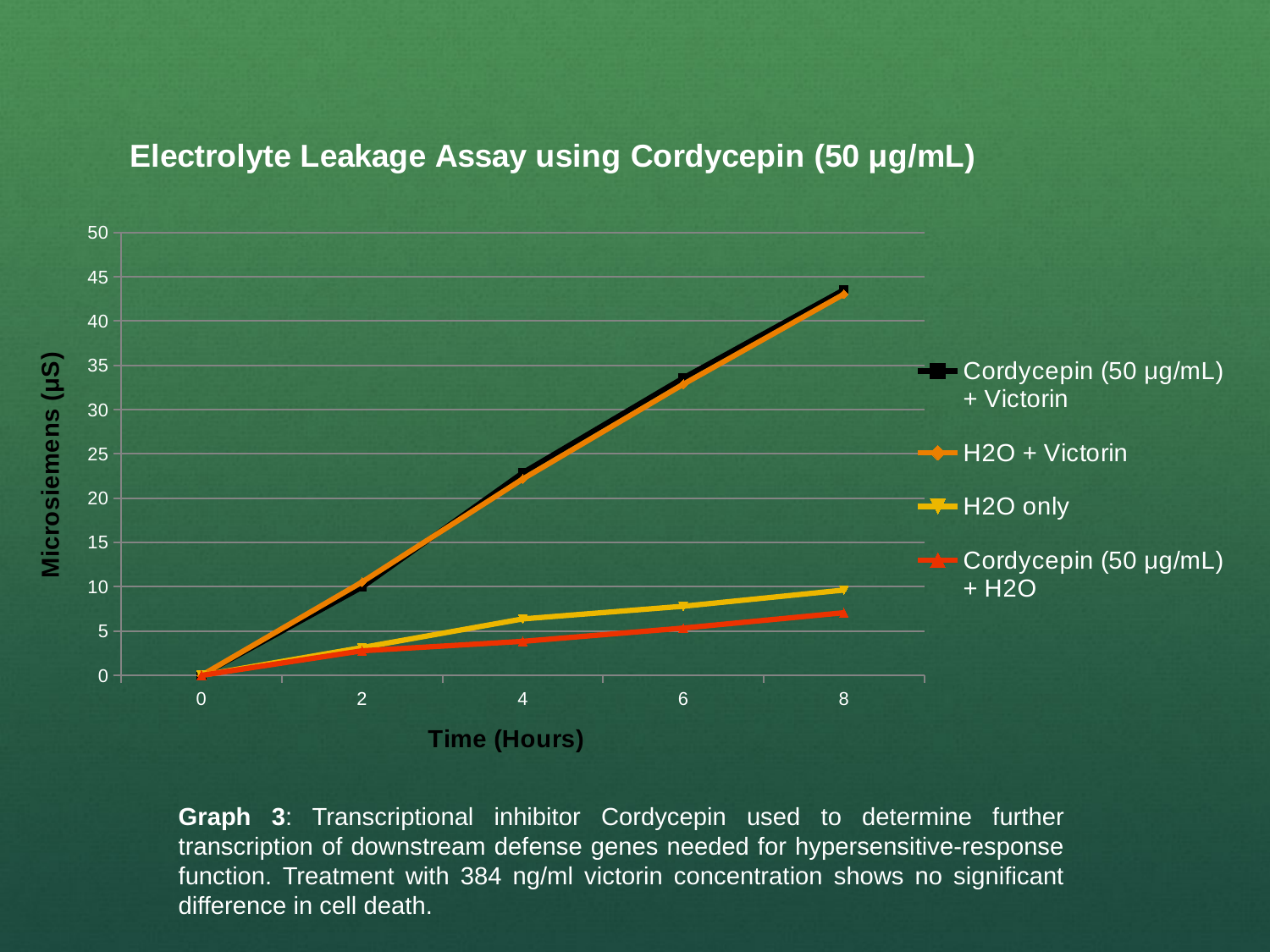
How many time points are plotted along the x axis? 5 Is the value for H2O only at 8 hours greater or less than 15? less What is the label of the y axis? Microsiemens (µS) Which series has the lowest value at 8 hours? Cordycepin (50 µg/mL) + H2O What kind of chart is shown on the slide? line chart Do the values for H2O + Victorin rise or fall as time increases? rise What is the value for Cordycepin (50 µg/mL) + Victorin at 0 hours? 0 Is the value for Cordycepin (50 µg/mL) + Victorin at 8 hours greater or less than 40? greater Is the value for Cordycepin (50 µg/mL) + H2O at 8 hours greater or less than 10? less At 8 hours, which is larger: H2O only or Cordycepin (50 µg/mL) + H2O? H2O only How many series does the legend list? 4